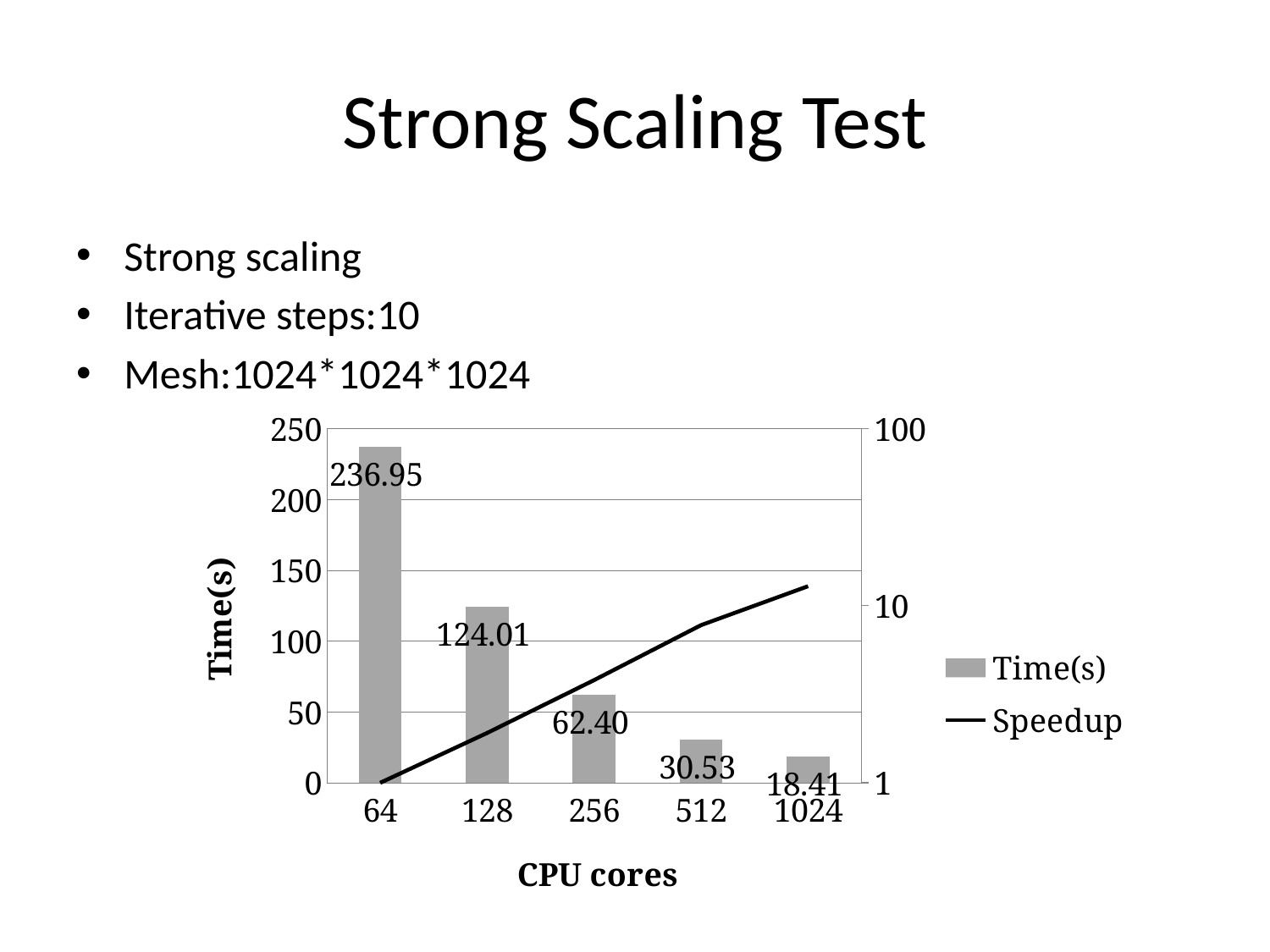
How many series does the legend list? 2 Is the Speedup value at 1024 CPU cores greater or less than 10? greater What is the Time(s) value at 64 CPU cores? 236.95 Which has a larger Time(s), 128 CPU cores or 256 CPU cores? 128 Which CPU core count has the highest Time(s)? 64 Does the Time(s) rise or fall as the number of CPU cores increases? fall What is the Time(s) value at 256 CPU cores? 62.40 How many CPU core counts are shown on the x axis? 5 What is the difference in Time(s) between 512 and 1024 CPU cores? 12.12 What is the Time(s) value at 1024 CPU cores? 18.41 Which CPU core count has the lowest Time(s)? 1024 What is the difference in Time(s) between 64 and 128 CPU cores? 112.94